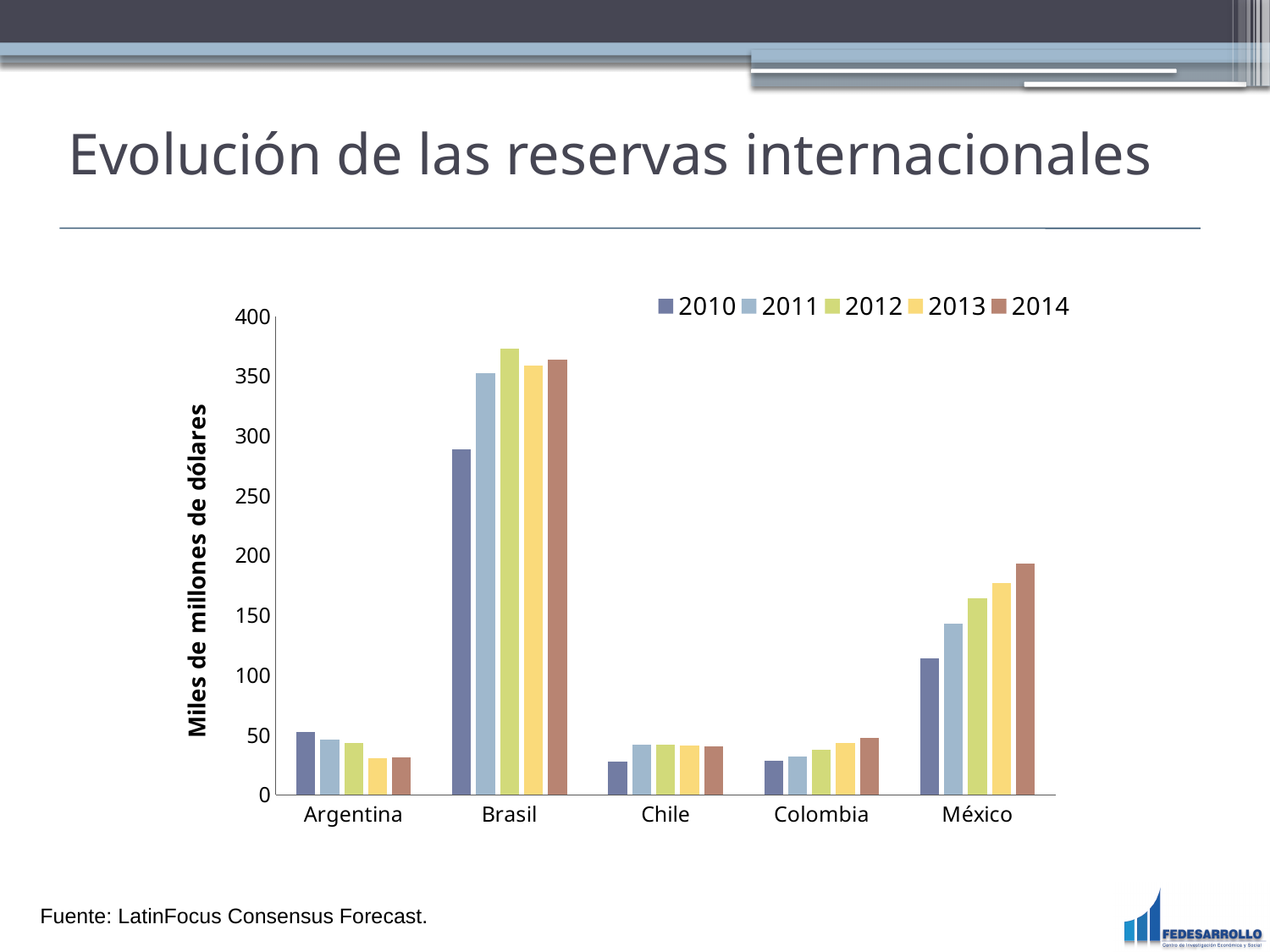
What is the label on the y axis? Miles de millones de dólares Is the value for Brasil in 2010 greater or less than 300? less Is the value for Brasil in 2012 greater or less than 350? greater Is the value for México in 2014 greater or less than 150? greater Do the values for México rise or fall from 2010 to 2014? rise How many countries are shown on the x axis? 5 Which country has the highest value for 2012? Brasil What kind of chart is shown on the slide? Bar chart How many series does the legend list? 5 Which is larger: the value for Brasil in 2011 or the value for México in 2014? Brasil in 2011 Which country has the lowest value for 2014? Argentina